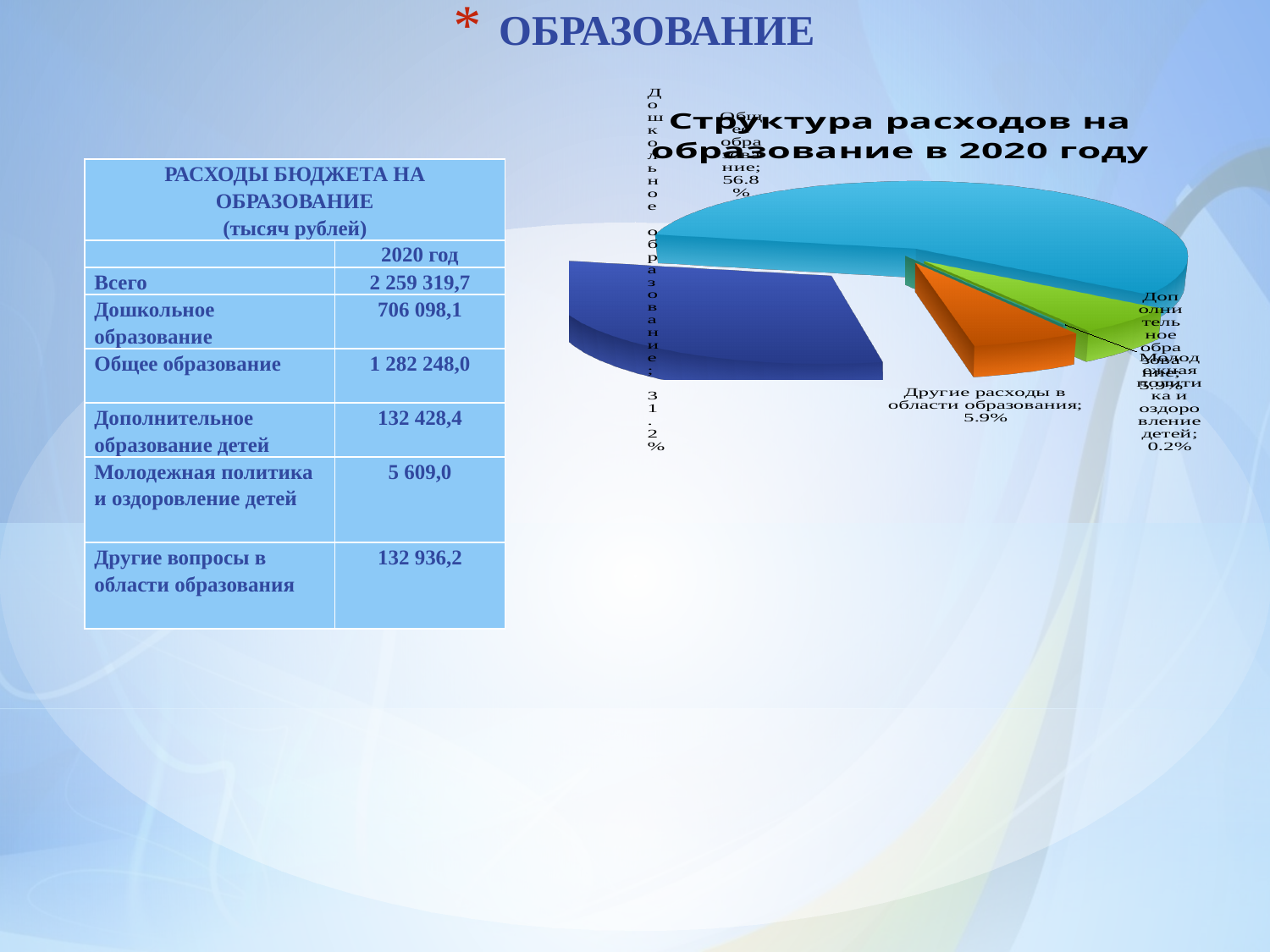
What kind of chart is shown on the slide? Pie chart How many slices does the pie chart have? 5 Which category has the largest slice in the pie chart? Общее образование In the pie chart, by how many percentage points does Общее образование exceed Дошкольное образование? 25.6 In the pie chart, what share does Общее образование have? 56.8% In the pie chart, what share do Другие расходы в области образования have? 5.9% In the pie chart, which is larger: Другие расходы в области образования or Молодежная политика и оздоровление детей? Другие расходы в области образования Which category has the smallest slice in the pie chart? Молодежная политика и оздоровление детей What is the title of the pie chart? Структура расходов на образование в 2020 году In the pie chart, which is larger: Общее образование or Дошкольное образование? Общее образование In the pie chart, what share does Дошкольное образование have? 31.2%